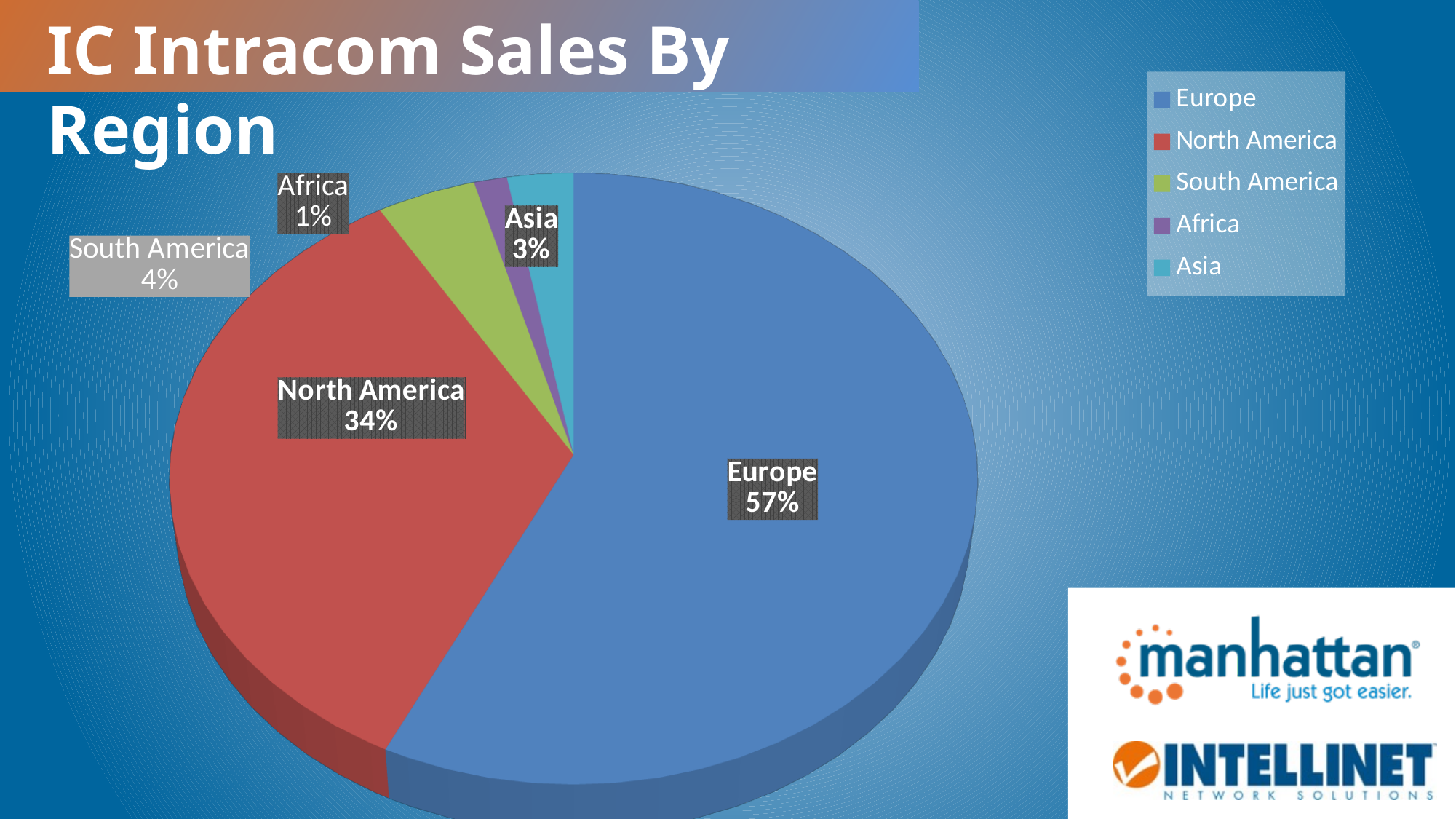
Which region has the largest share of sales? Europe How many percentage points larger is Europe's share than North America's? 23 How many regions are shown in the pie chart? 5 Which region has the smallest share of sales? Africa What share of IC Intracom sales does Europe account for? 57% What percentage is shown for Asia? 3% What is the value shown for South America? 4% What is the title of the chart? IC Intracom Sales By Region What type of chart is shown on the slide? Pie chart What percentage of sales comes from North America? 34% Which region has a larger share, South America or Asia? South America What colour represents North America in the chart? Red